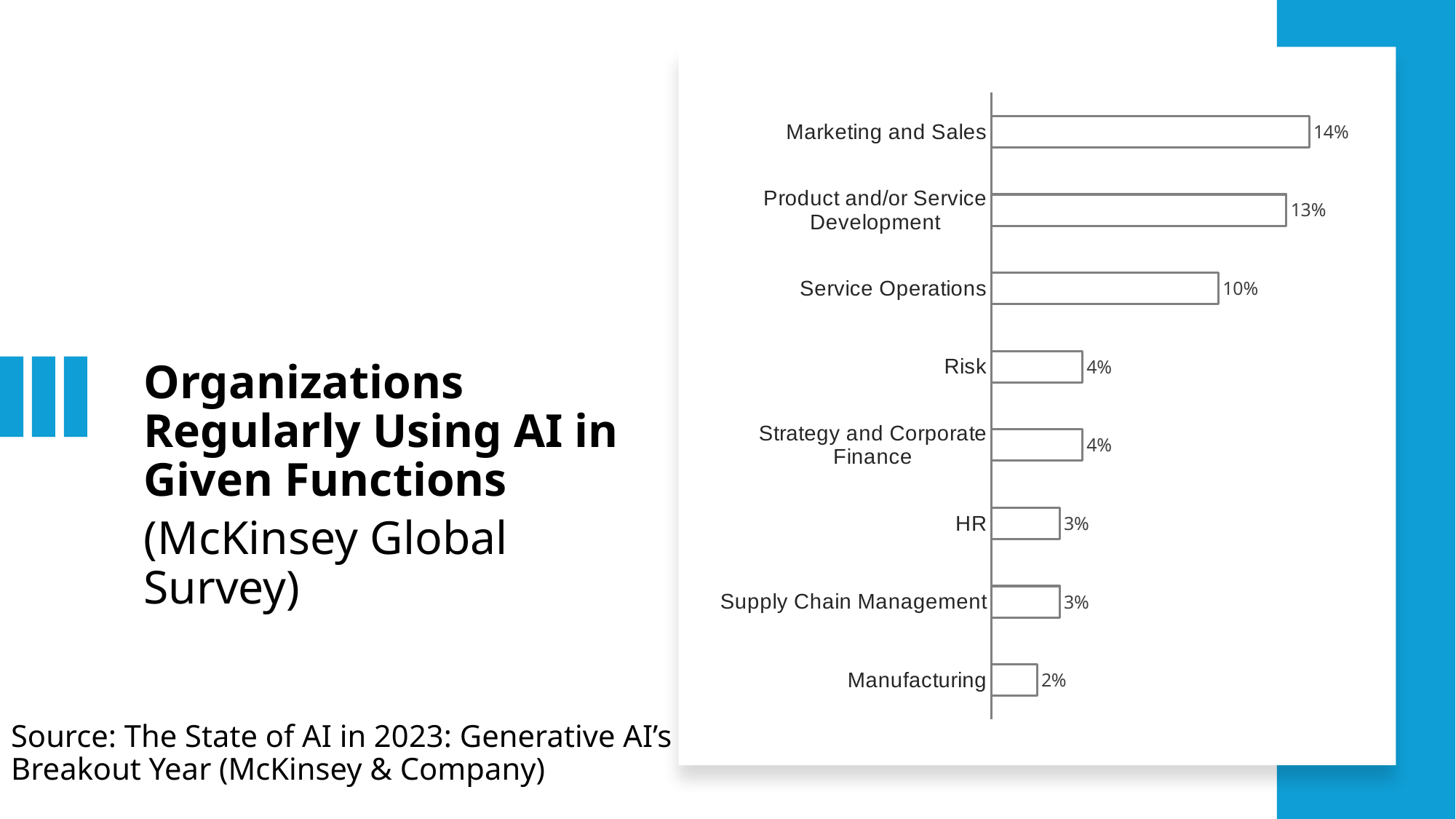
What percentage of organizations regularly use AI in Marketing and Sales? 14% Which function has the highest value in the chart? Marketing and Sales What is the difference between the values for Marketing and Sales and Product and/or Service Development? 1% What is the value shown for Strategy and Corporate Finance? 4% Which function has the lowest value in the chart? Manufacturing What is the value shown for Service Operations? 10% Do the values rise or fall going from the top bar to the bottom bar? Fall How many functions are shown in the chart? 8 What is the difference between the values for Service Operations and Risk? 6% What is the value shown for Supply Chain Management? 3% What kind of chart is shown on the slide? Bar chart Which is larger, the value for Service Operations or the value for HR? Service Operations